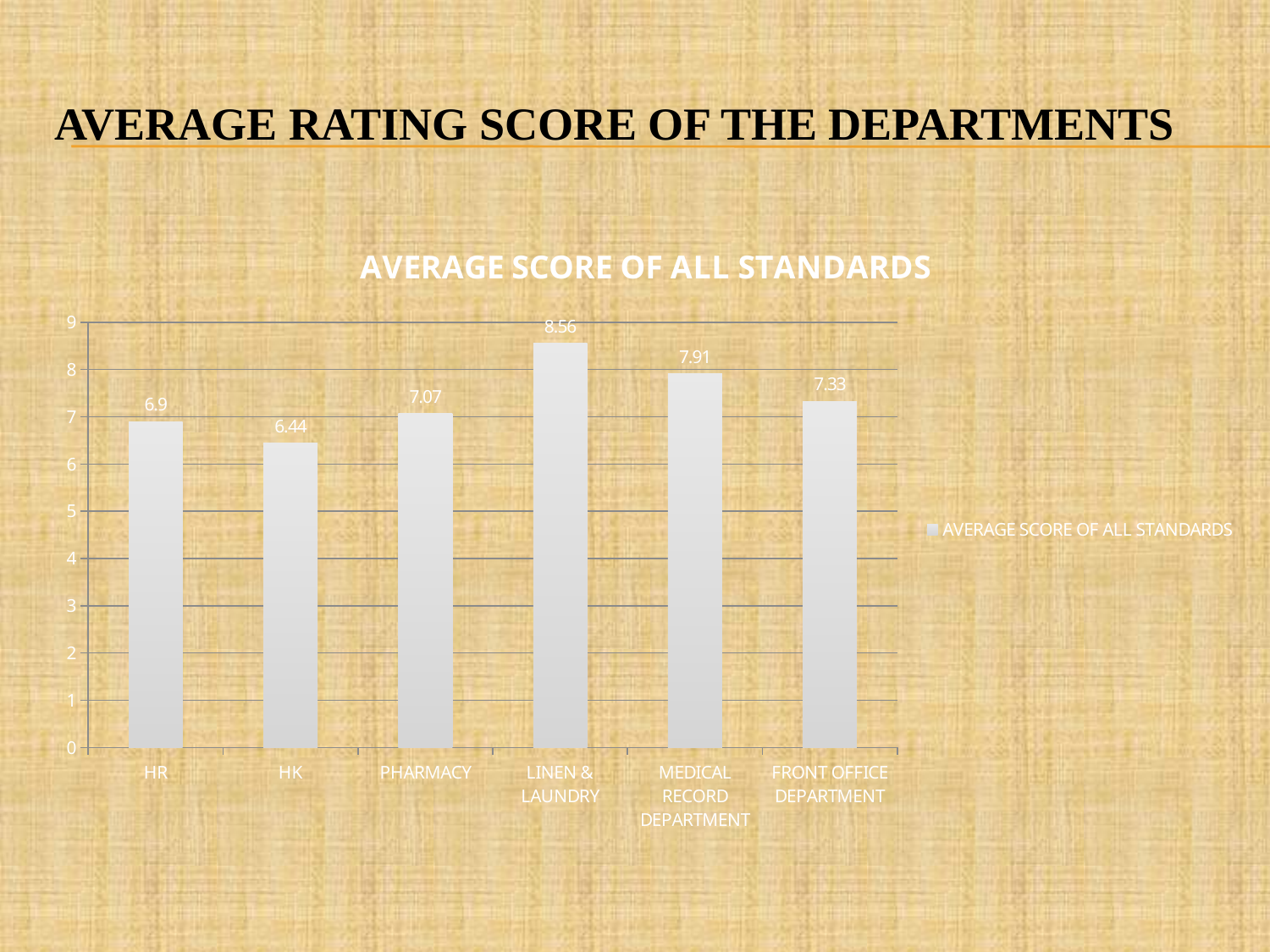
Is the value for Medical Record Department greater or less than 8? less Which has a higher average score, Front Office Department or Pharmacy? Front Office Department What is the average score for the Medical Record Department? 7.91 What is the title of the chart? AVERAGE SCORE OF ALL STANDARDS What is the difference between the average scores of Linen & Laundry and HK? 2.12 What kind of chart is shown on the slide? Bar chart What is the average score for Pharmacy? 7.07 How many series does the legend list? 1 How many departments are shown in the chart? 6 Which department has the highest average score? Linen & Laundry Which department has the lowest average score? HK What is the average score for HR? 6.9